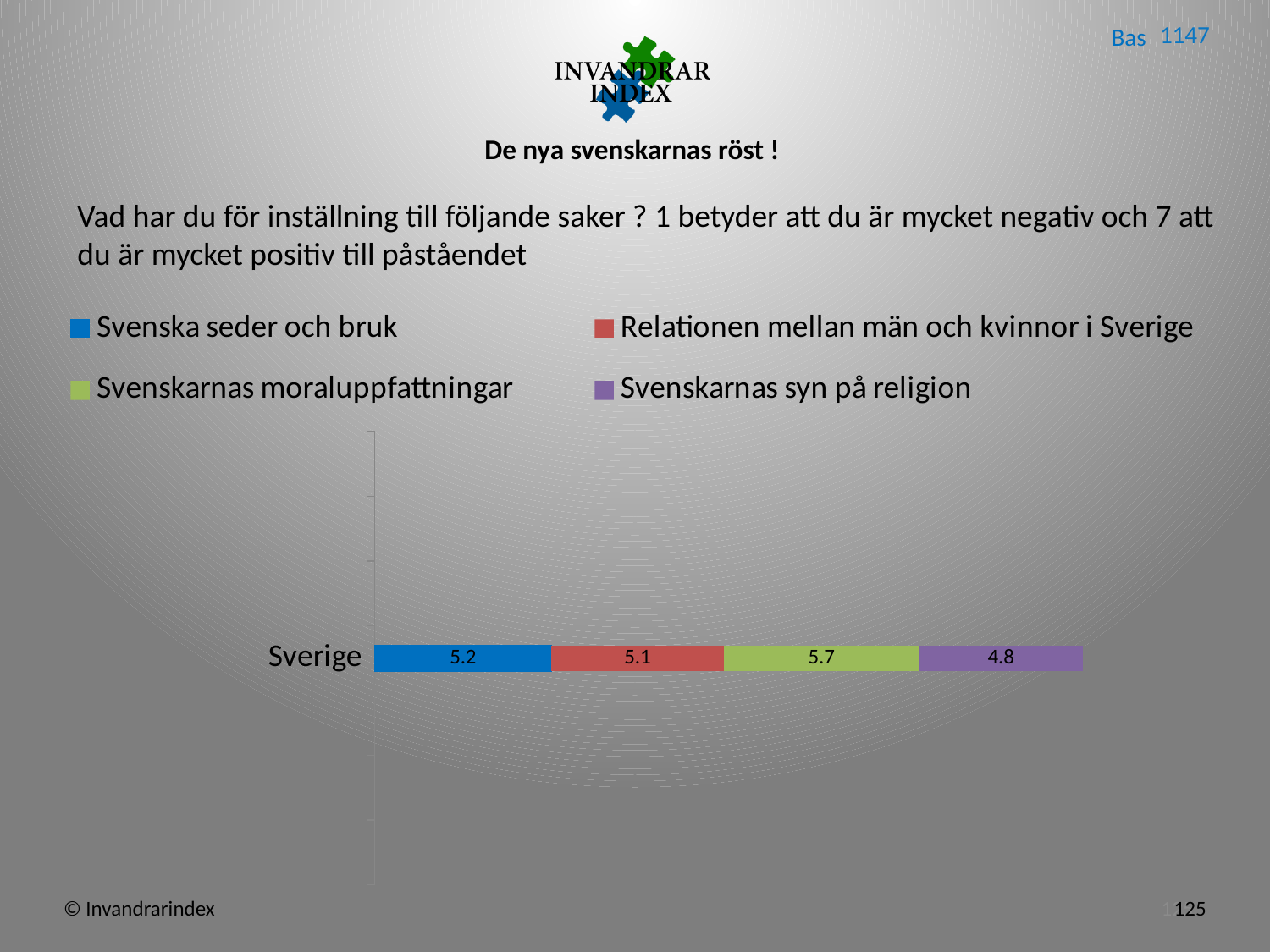
Which series has the highest value for Sverige? Svenskarnas moraluppfattningar What kind of chart is shown on the slide? Stacked bar chart Which series has the lowest value for Sverige? Svenskarnas syn på religion What is the value for Svenskarnas syn på religion? 4.8 What is the value for Svenskarnas moraluppfattningar? 5.7 What is the value for Svenska seder och bruk for Sverige? 5.2 What is the difference between the values for Svenskarnas moraluppfattningar and Svenskarnas syn på religion? 0.9 How many series does the legend list? 4 Which is larger, the value for Svenska seder och bruk or the value for Relationen mellan män och kvinnor i Sverige? Svenska seder och bruk What is the total of the stacked bar for Sverige? 20.8 How many categories are shown on the chart? 1 What is the value for Relationen mellan män och kvinnor i Sverige? 5.1